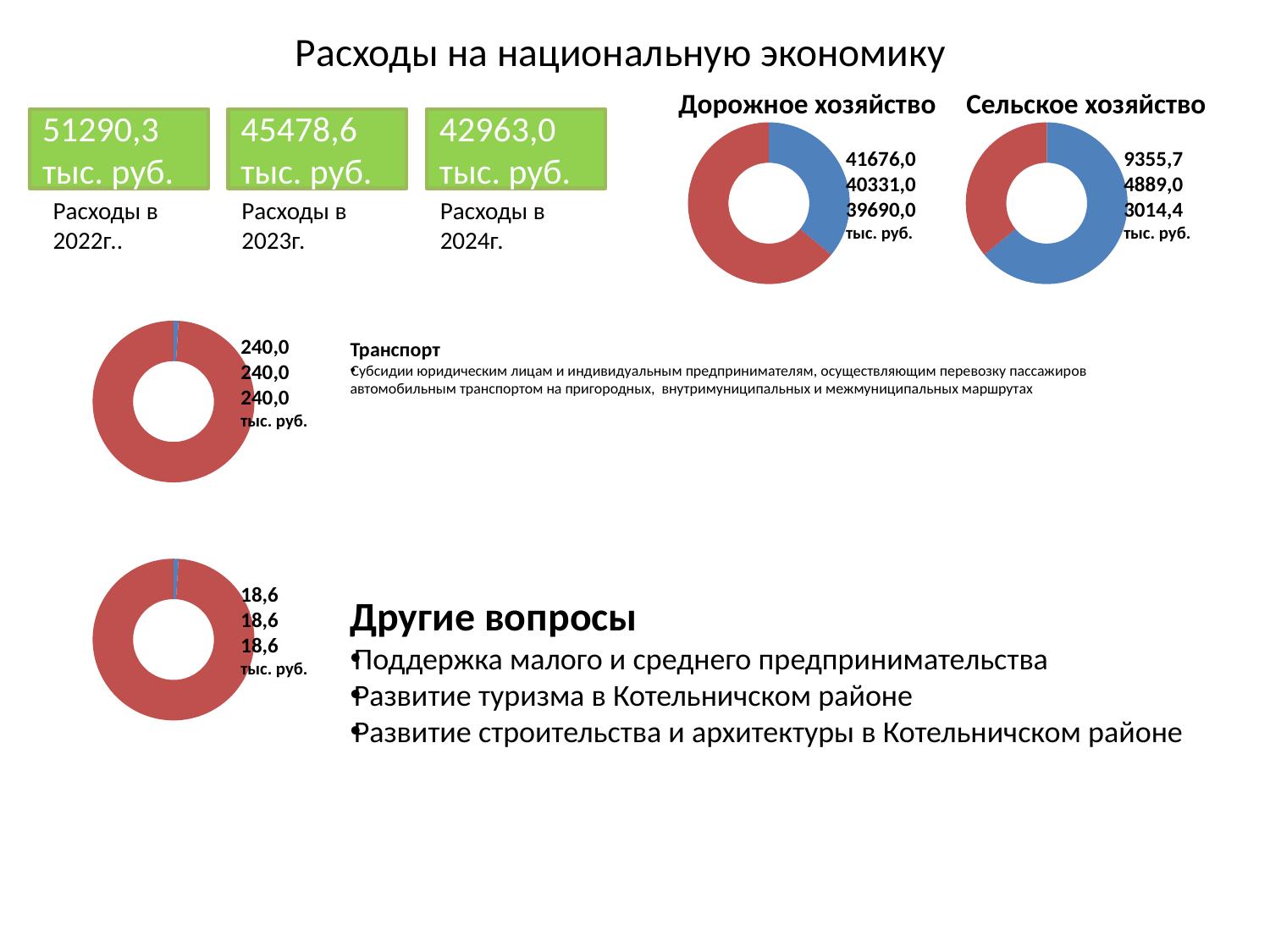
What value is listed next to the Другие вопросы chart for each of the three years? 18,6 тыс. руб. What is the middle value listed next to the Сельское хозяйство chart? 4889,0 тыс. руб. What is the smallest value listed next to the Сельское хозяйство chart? 3014,4 тыс. руб. How many doughnut charts are shown on the slide? 4 Which has the larger maximum listed value, Дорожное хозяйство or Сельское хозяйство? Дорожное хозяйство What is the difference between the largest (9355,7) and smallest (3014,4) values listed for Сельское хозяйство? 6341,3 тыс. руб. What kind of chart is used for Дорожное хозяйство? doughnut (pie) chart What is the largest value listed next to the Дорожное хозяйство chart? 41676,0 тыс. руб. What value is listed next to the Транспорт chart for each of the three years? 240,0 тыс. руб. What two colours are used for the slices of the Дорожное хозяйство doughnut chart? blue and red What is the difference between the largest (41676,0) and smallest (39690,0) values listed for Дорожное хозяйство? 1986,0 тыс. руб. What is the title of the chart in the top-right corner of the slide? Сельское хозяйство